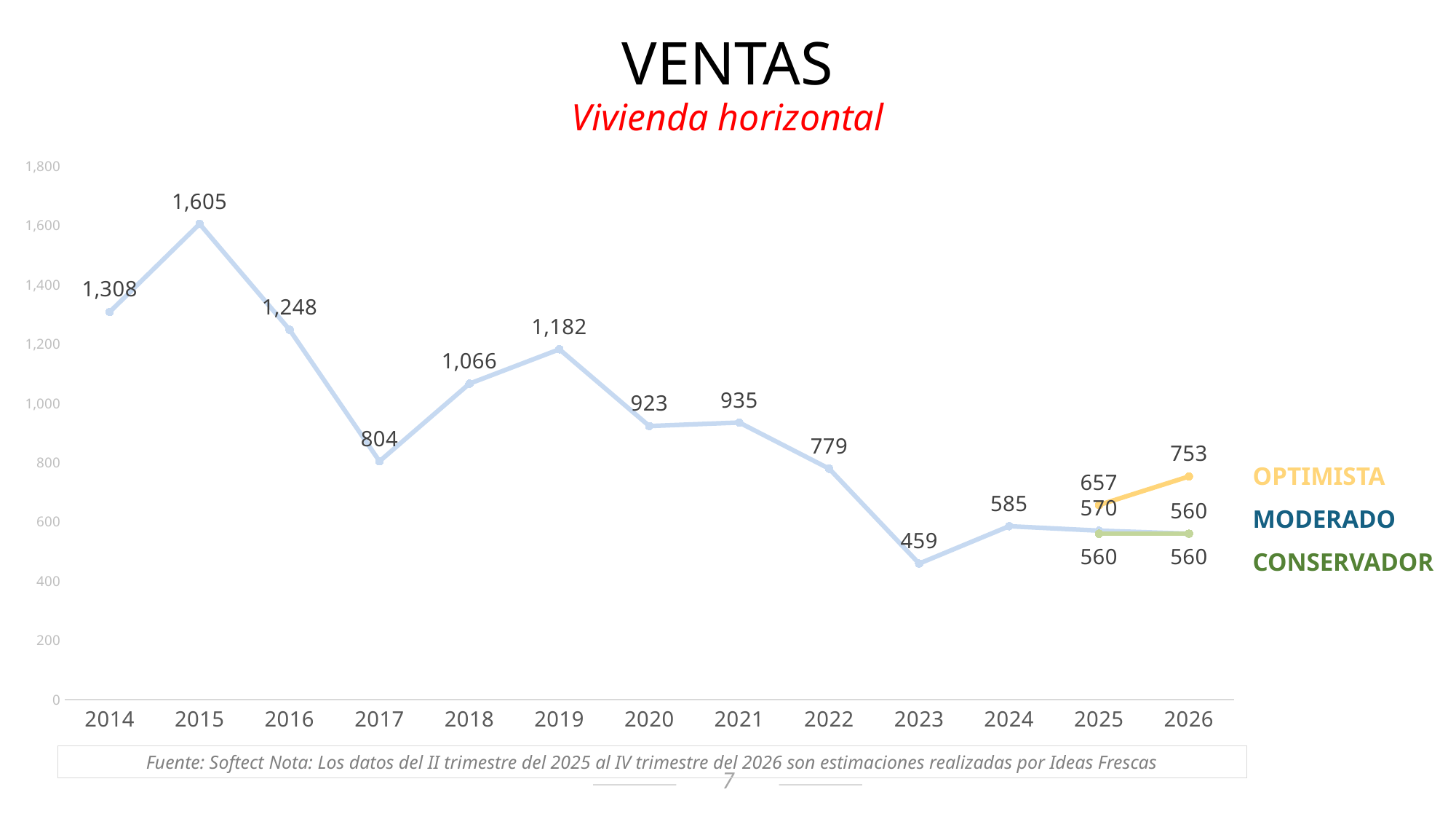
What is the CONSERVADOR scenario value for 2025? 560 What is the sales value for 2023? 459 What is the sales value for 2015? 1,605 Which year has the highest sales value? 2015 What is the difference between the sales values for 2015 and 2016? 357 Which year has the lowest sales value? 2023 What is the OPTIMISTA scenario value for 2026? 753 What type of chart is shown on the slide? line chart Which year has a larger sales value, 2020 or 2021? 2021 How many years are shown on the x axis? 13 What is the subtitle shown in red below the chart title? Vivienda horizontal What is the sales value for 2017? 804